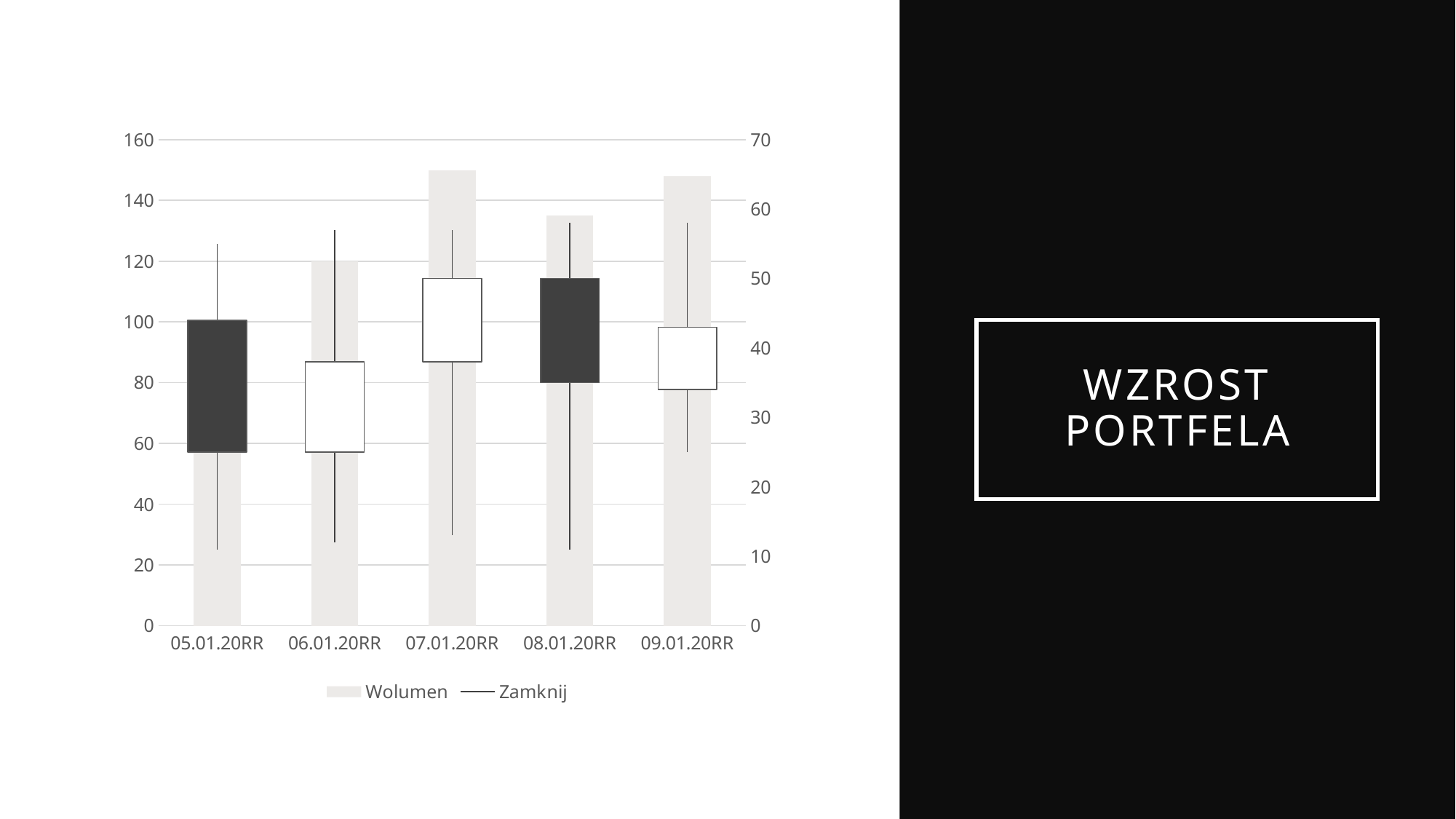
Which date has the lowest Wolumen bar? 05.01.20RR Is the Wolumen value for 08.01.20RR greater or less than 140? less Is the Wolumen value for 05.01.20RR greater or less than 120? less What are the two entries in the chart legend? Wolumen and Zamknij Which has the larger Wolumen bar, 05.01.20RR or 06.01.20RR? 06.01.20RR How many series does the chart legend list? 2 What is the Wolumen value for 06.01.20RR? 120 Which has the larger Wolumen bar, 07.01.20RR or 08.01.20RR? 07.01.20RR What kind of chart is shown on the slide? Stock (candlestick) chart with volume bars Is the Wolumen value for 07.01.20RR greater or less than 140? greater What is the maximum value shown on the right-hand axis of the chart? 70 How many dates are shown on the x axis of the chart? 5